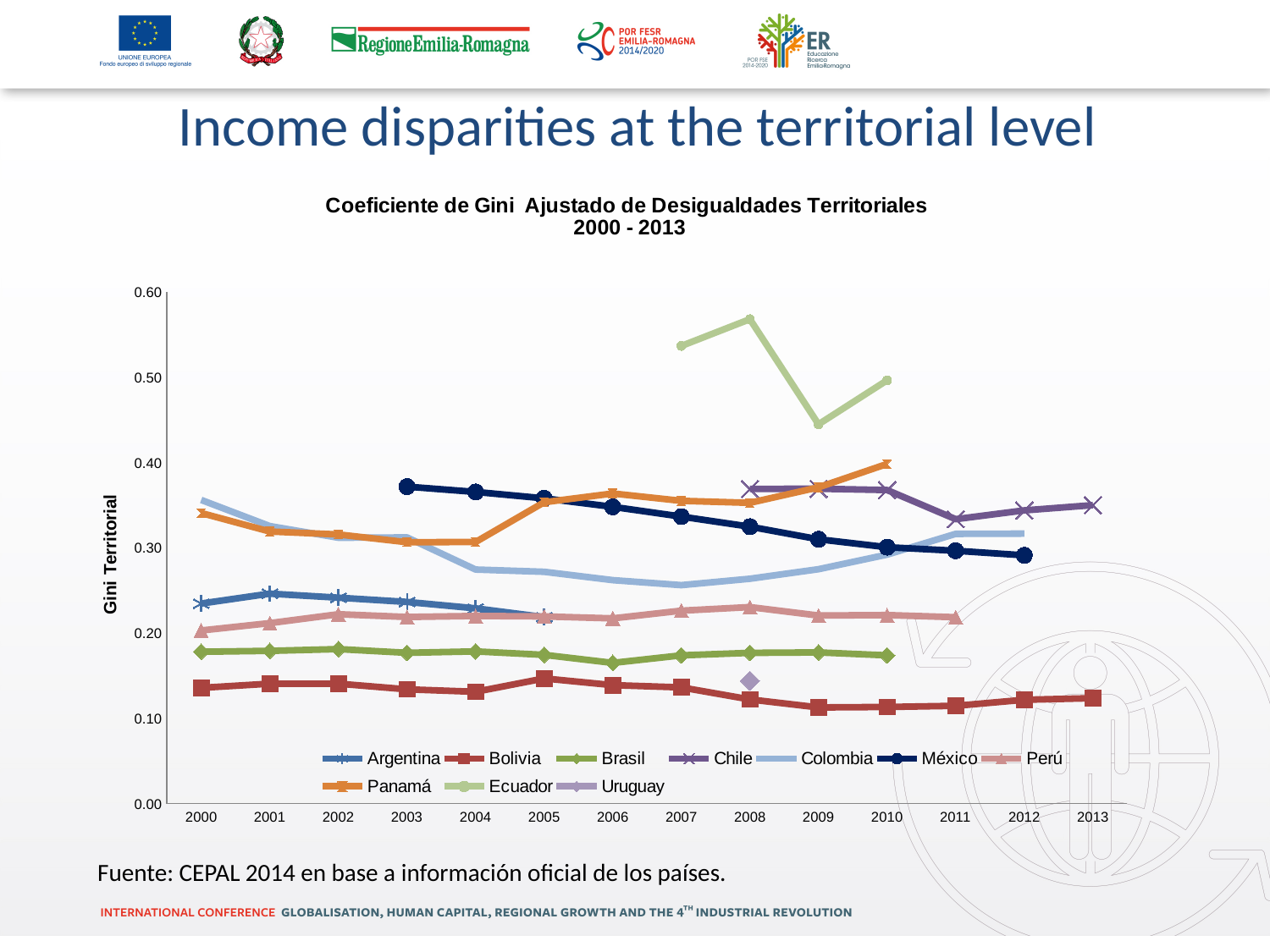
Which is larger in 2003, the value for México or the value for Colombia? México Is the value for Chile in 2008 greater or less than 0.30? greater Is the value for Ecuador in 2008 greater or less than 0.50? greater Which country's line is the lowest across the chart? Bolivia How many countries does the legend list? 10 What is the label of the y axis? Gini Territorial How many years are shown on the x axis? 14 What kind of chart is shown on the slide? line chart Is the value for Bolivia in 2009 greater or less than 0.20? less Which country has the highest Gini Territorial values on the chart? Ecuador Does the line for Panamá rise or fall from 2004 to 2010? rise